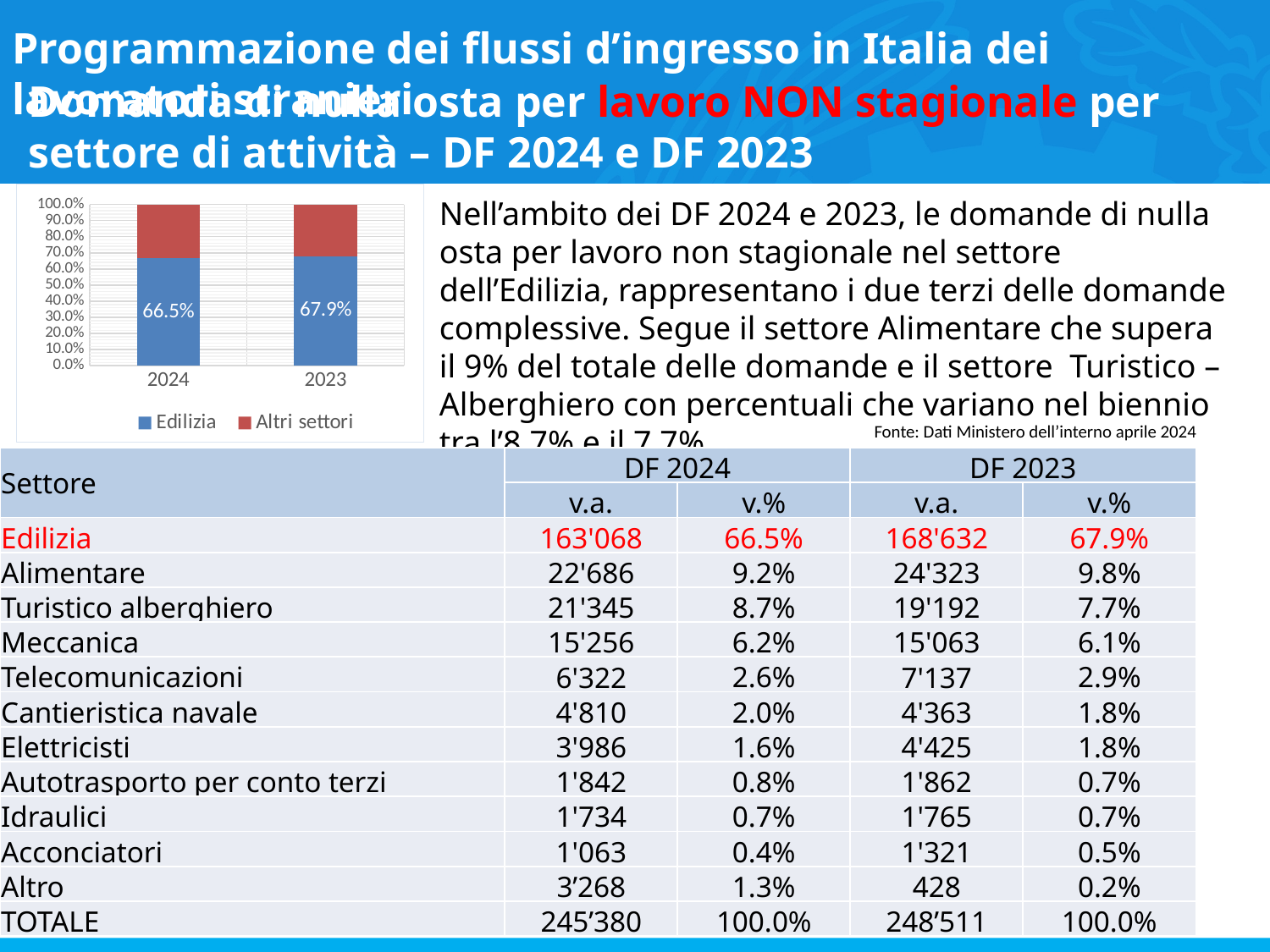
What kind of chart is shown on the left of the slide? Stacked bar chart In the stacked bar chart, what is the Edilizia share for 2024? 66.5% How many series does the legend of the stacked bar chart list? 2 In the stacked bar chart, is the Edilizia share for 2024 greater or less than 60.0%? greater How many categories (years) are shown on the x axis of the stacked bar chart? 2 What are the two series named in the legend of the stacked bar chart? Edilizia and Altri settori In the stacked bar chart, is the Altri settori share for 2024 greater or less than 40.0%? less In the stacked bar chart, which year has the highest Edilizia share? 2023 In the stacked bar chart, what colour represents the Edilizia series? Blue In the stacked bar chart, what is the difference between the Edilizia share in 2023 and in 2024? 1.4% In the stacked bar chart, which year has the larger Edilizia share, 2024 or 2023? 2023 In the stacked bar chart, what is the Edilizia share for 2023? 67.9%